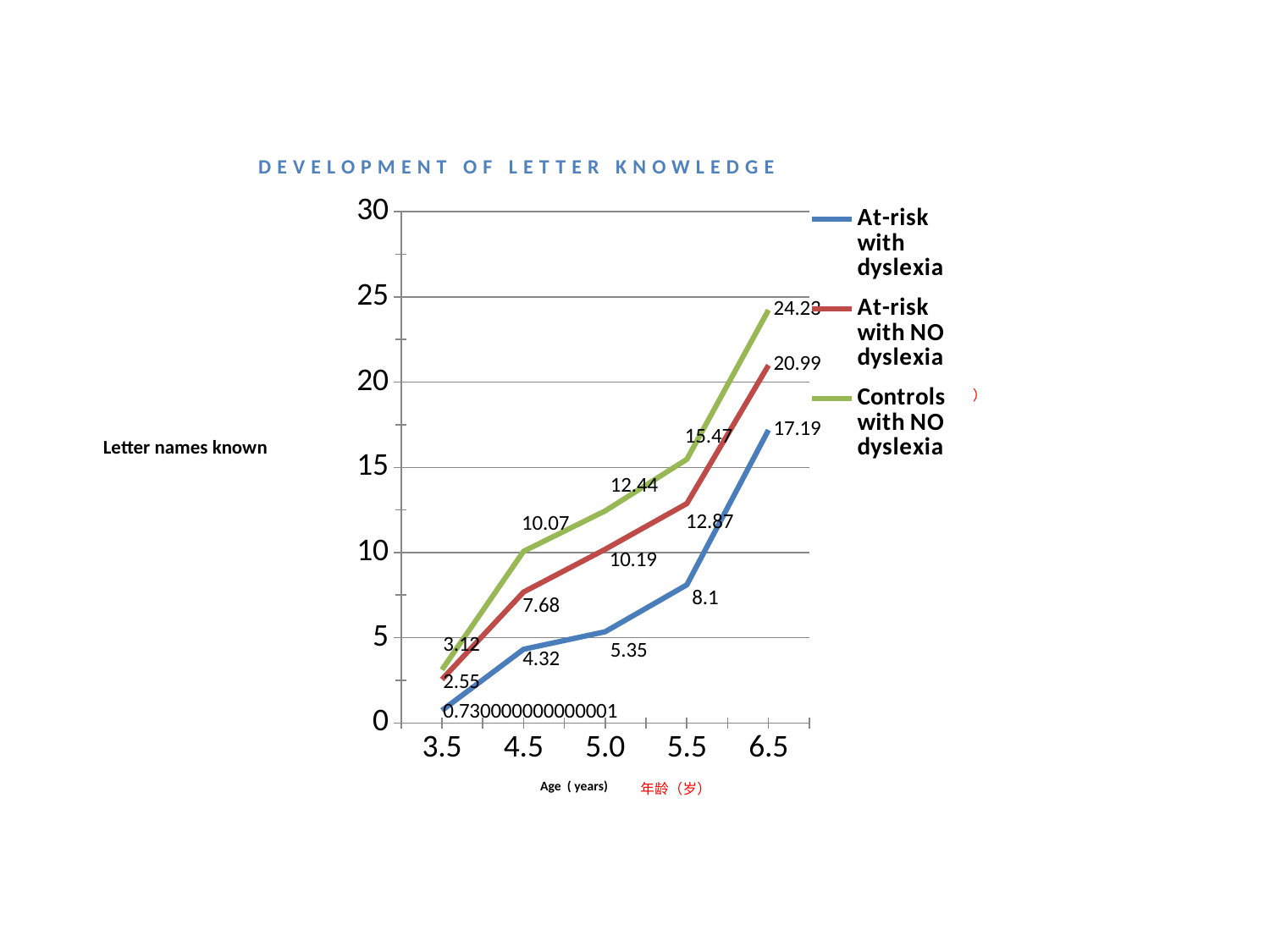
What kind of chart is shown on the slide? Line chart How many series does the legend list? 3 What is the value for Controls with NO dyslexia at age 4.5? 10.07 Do the values for At-risk with dyslexia rise or fall as age increases? Rise What is the value for At-risk with dyslexia at age 5.5? 8.1 Is the value for Controls with NO dyslexia at age 6.5 greater or less than 20? greater Which series has the lowest value at age 3.5? At-risk with dyslexia What is the value for At-risk with dyslexia at age 6.5? 17.19 Which series has the highest value at age 6.5? Controls with NO dyslexia What is the difference between At-risk with NO dyslexia and At-risk with dyslexia at age 6.5? 3.8 How many age points are plotted along the x axis? 5 What is the value for At-risk with NO dyslexia at age 5.0? 10.19